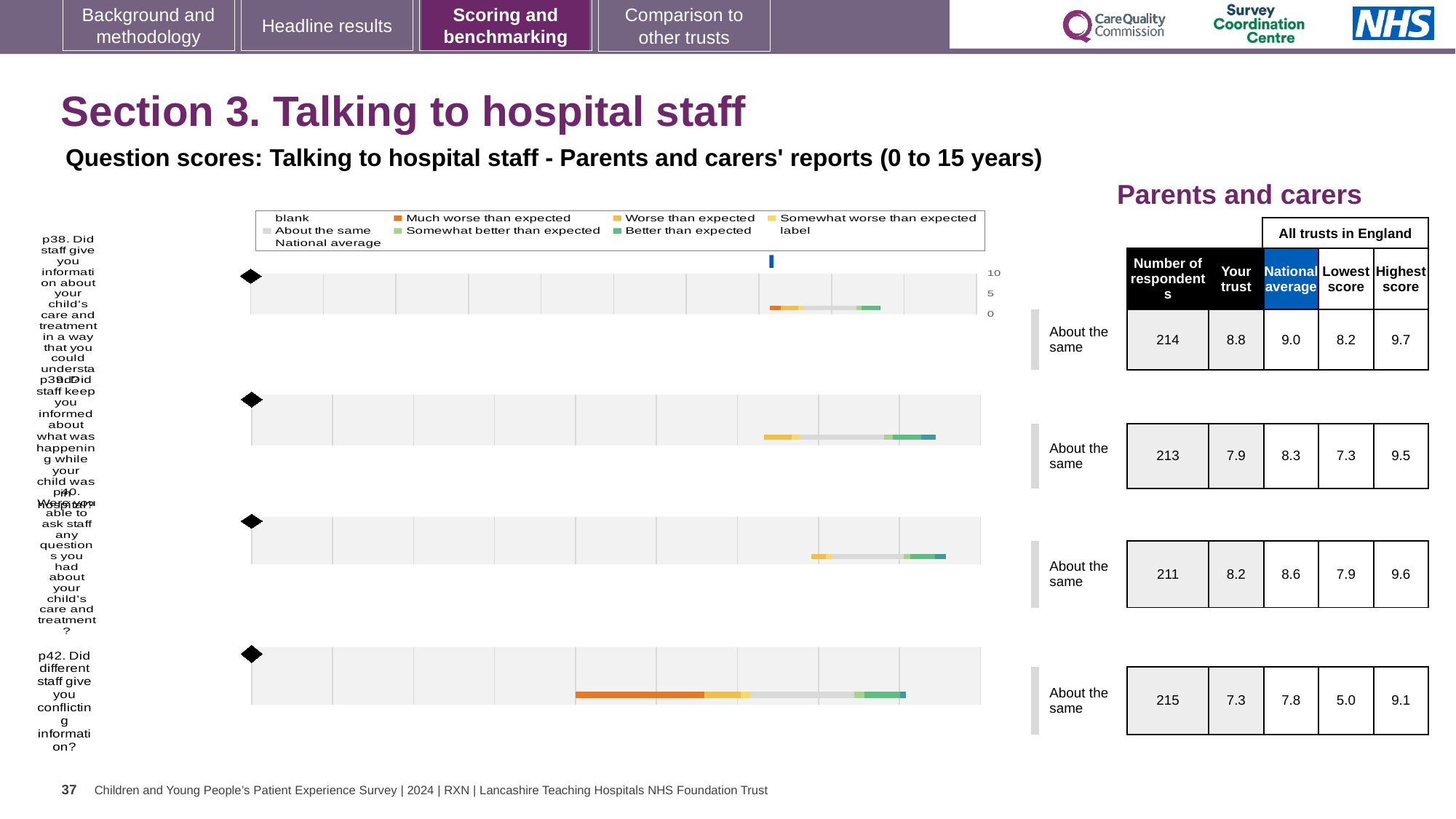
Which question has the highest 'Your trust' score? p38 Which question has the lowest 'Your trust' score? p42 For question p39, is the 'Your trust' score higher or lower than the national average? lower What is the 'Your trust' score for question p38 (Did staff give you information about your child's care and treatment in a way that you could understand)? 8.8 What kind of chart is used to show the question scores on this slide? bar chart How many survey questions (p38, p39, p40, p42) are charted on this slide? 4 For question p42, what is the difference between the highest score and the lowest score across all trusts in England? 4.1 What benchmark category is shown next to each of the four question charts? About the same What is the national average score for question p42 (Did different staff give you conflicting information)? 7.8 How many respondents are listed for question p40 (Were you able to ask staff any questions you had about your child's care and treatment)? 211 What colour represents 'Much worse than expected' in the chart legend? orange For question p38, how much higher is the national average than the 'Your trust' score? 0.2